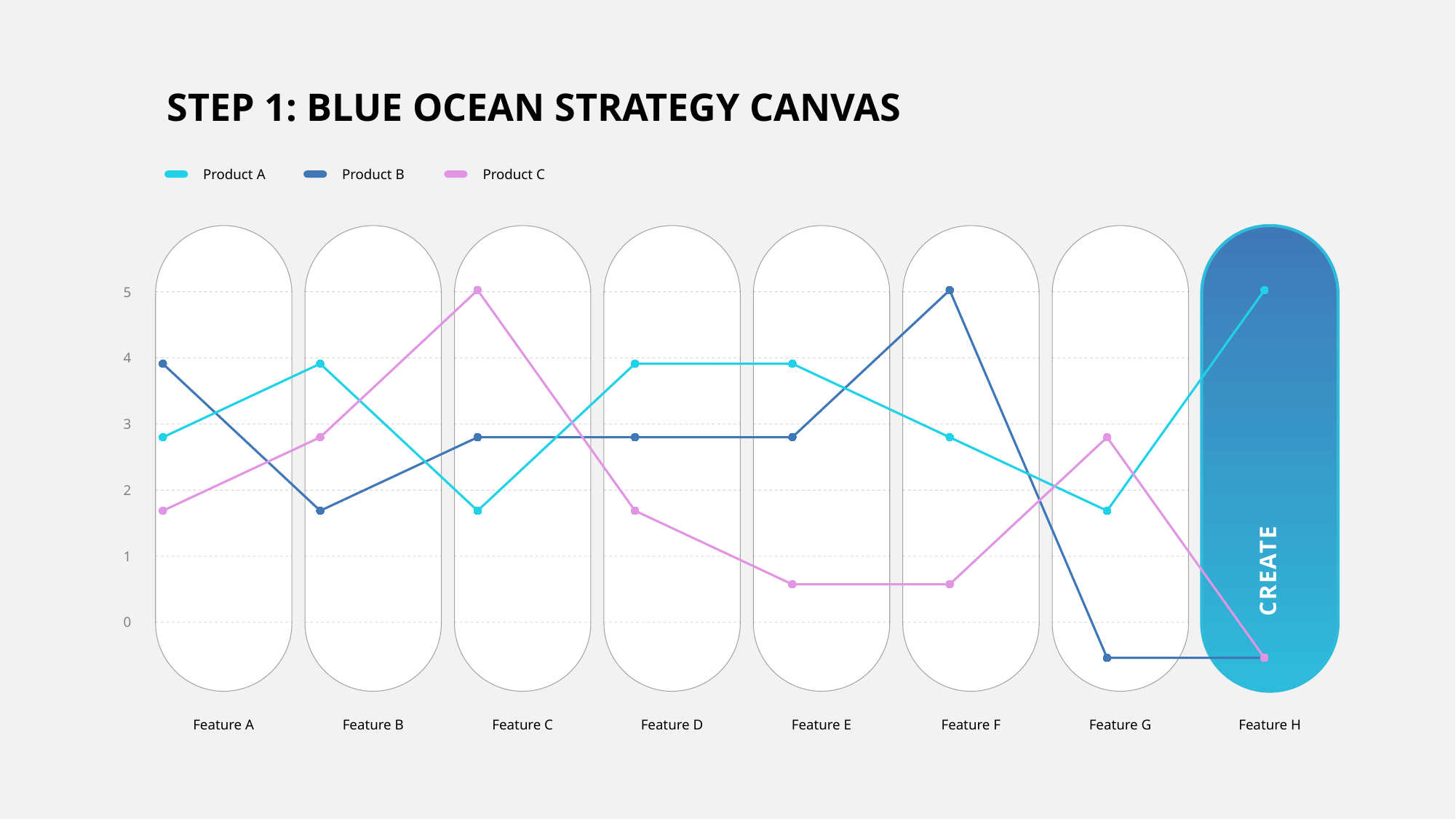
What is the value of Product A at Feature H? 5 At which feature does Product A reach its highest value? Feature H At Feature A, which is higher: Product A or Product B? Product B What word is written on the highlighted column for Feature H? CREATE At which feature does Product C have its lowest value? Feature H What kind of chart is shown on the slide? line chart What is the value of Product C at Feature C? 5 What is the value of Product B at Feature F? 5 How many series does the legend list? 3 At which feature does Product C reach its highest value? Feature C How many features are plotted along the x axis? 8